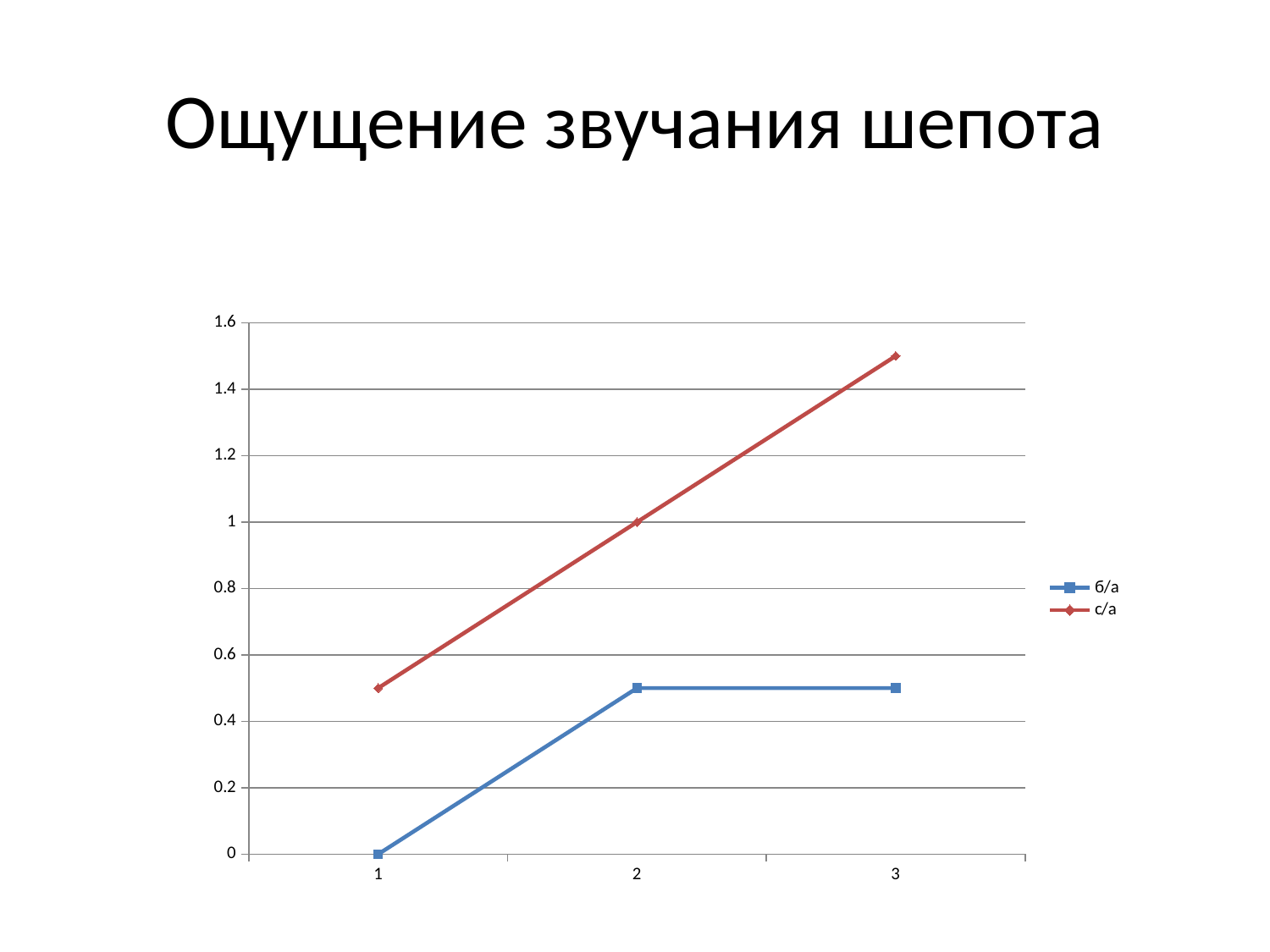
How many points are plotted along the x axis for each series? 3 Is the value of the б/а series at x = 2 greater or less than 0.6? less What is the value of the с/а series at x = 2? 1 Is the value of the с/а series at x = 3 greater or less than 1.4? greater Does the с/а series rise or fall from x = 1 to x = 3? rise At which x value does the с/а series reach its highest point? 3 At which x value does the б/а series have its lowest point? 1 Is the value of the с/а series at x = 1 greater or less than 0.4? greater What is the value of the б/а series at x = 1? 0 Which series has the higher value at x = 3, б/а or с/а? с/а How many series does the legend list? 2 What kind of chart is shown on the slide? line chart